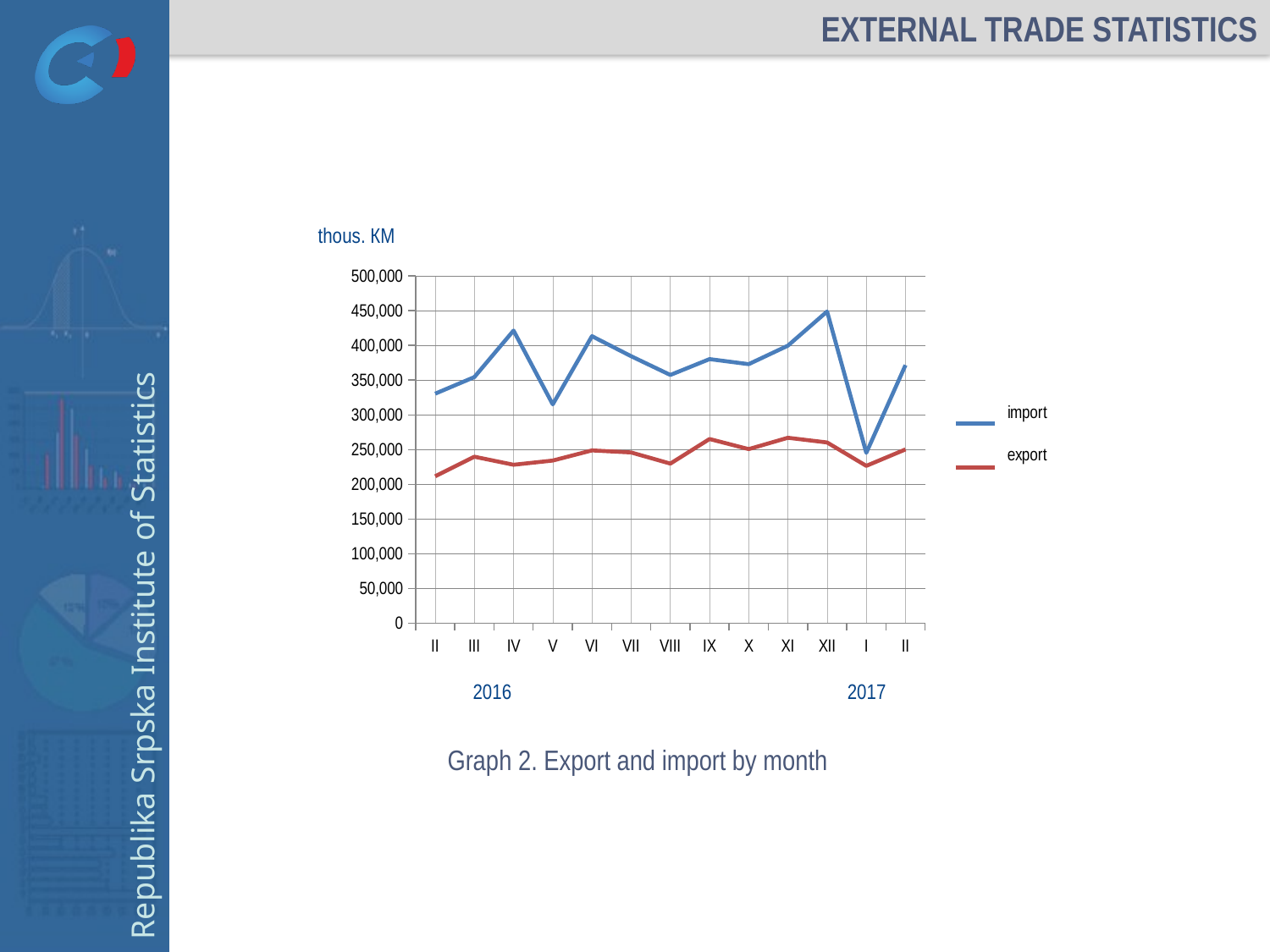
How many monthly points are plotted along the x axis? 13 Is the export value for II 2016 greater or less than 250,000? less In which month is import highest? XII 2016 How many series does the legend list? 2 In which month is import lowest? I 2017 What unit is shown above the chart? thous. KM In which month is export lowest? II 2016 What kind of chart is shown on the slide? line chart Does import rise or fall from XII 2016 to I 2017? fall Which is larger in VI 2016, import or export? import Is the import value for XII 2016 greater or less than 400,000? greater Is the import value for I 2017 greater or less than 300,000? less